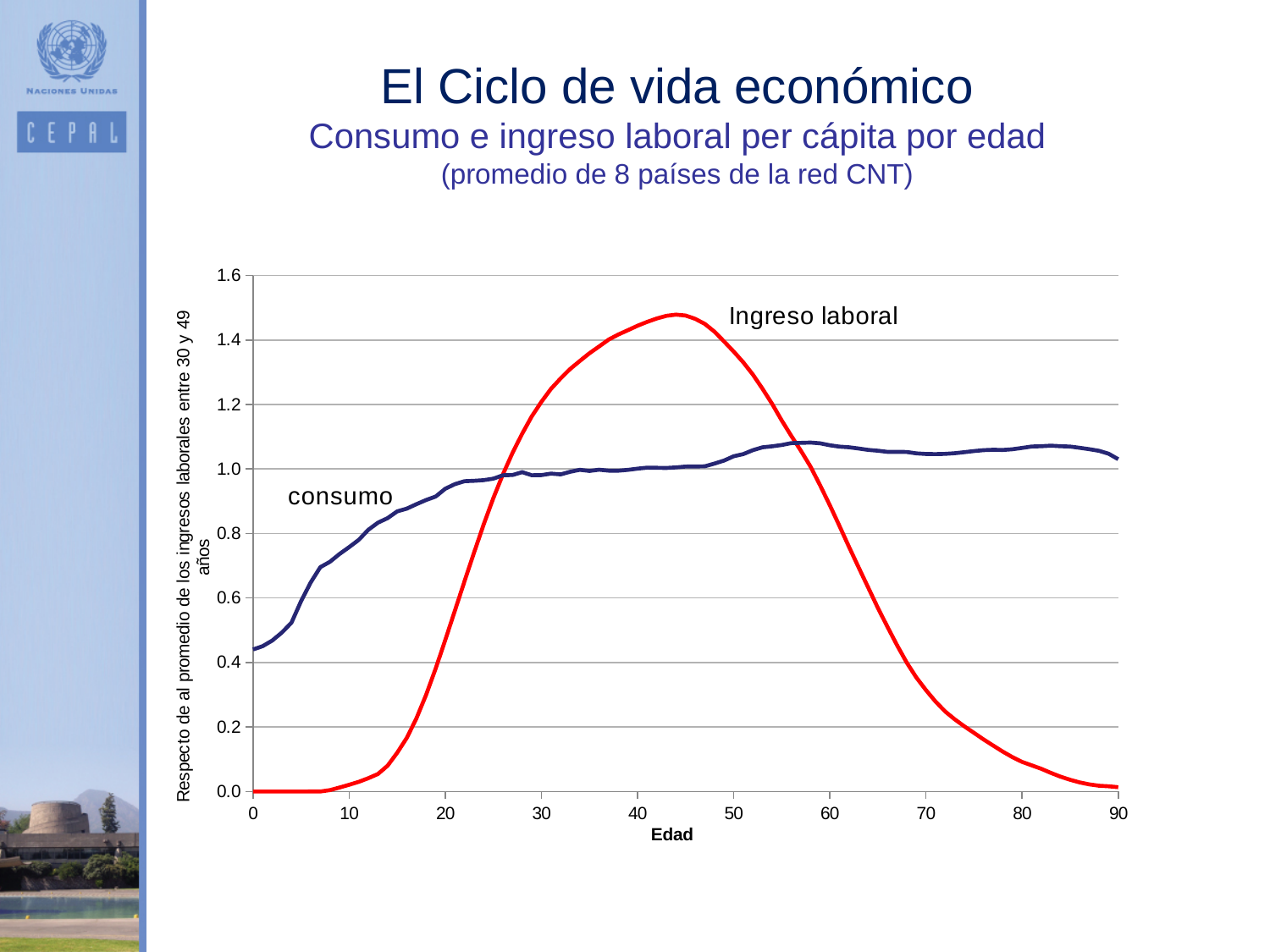
Is the value of consumo at age 0 greater or less than 0.6? less What is the label of the x axis? Edad At age 40, which series has the higher value, consumo or Ingreso laboral? Ingreso laboral Is the value of Ingreso laboral at age 40 greater or less than 1.2? greater How many series are plotted on the chart? 2 Which series reaches the highest value on the chart? Ingreso laboral Does the Ingreso laboral series rise or fall between age 50 and age 90? fall Is the value of Ingreso laboral at age 10 greater or less than 0.2? less At age 70, which series has the higher value, consumo or Ingreso laboral? consumo What kind of chart is shown on the slide? line chart Does the consumo series rise or fall between age 0 and age 20? rise